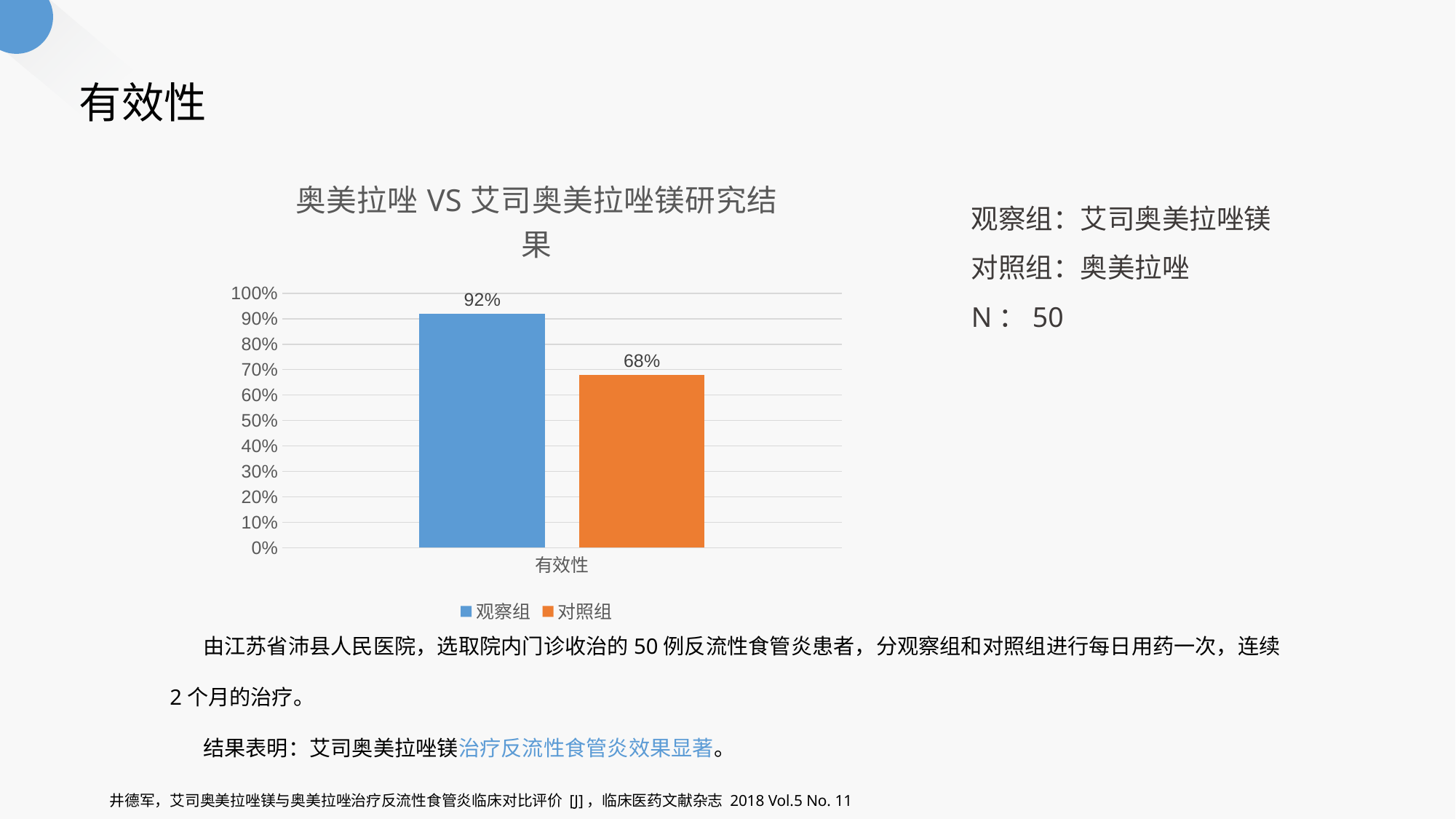
How many series does the legend list? 2 What is the value for 对照组 in the chart? 68% Which series has the lowest value in the chart? 对照组 What is the difference between the values for 观察组 and 对照组? 24% What colour is the bar for 对照组? orange Is the value for 观察组 greater or less than 90%? greater How many categories are shown on the x axis? 1 Which series has the higher value, 观察组 or 对照组? 观察组 What is the value for 观察组 in the chart? 92% What is the title of the chart? 奥美拉唑 VS 艾司奥美拉唑镁研究结果 What kind of chart is shown on the slide? bar chart Is the value for 对照组 greater or less than 70%? less